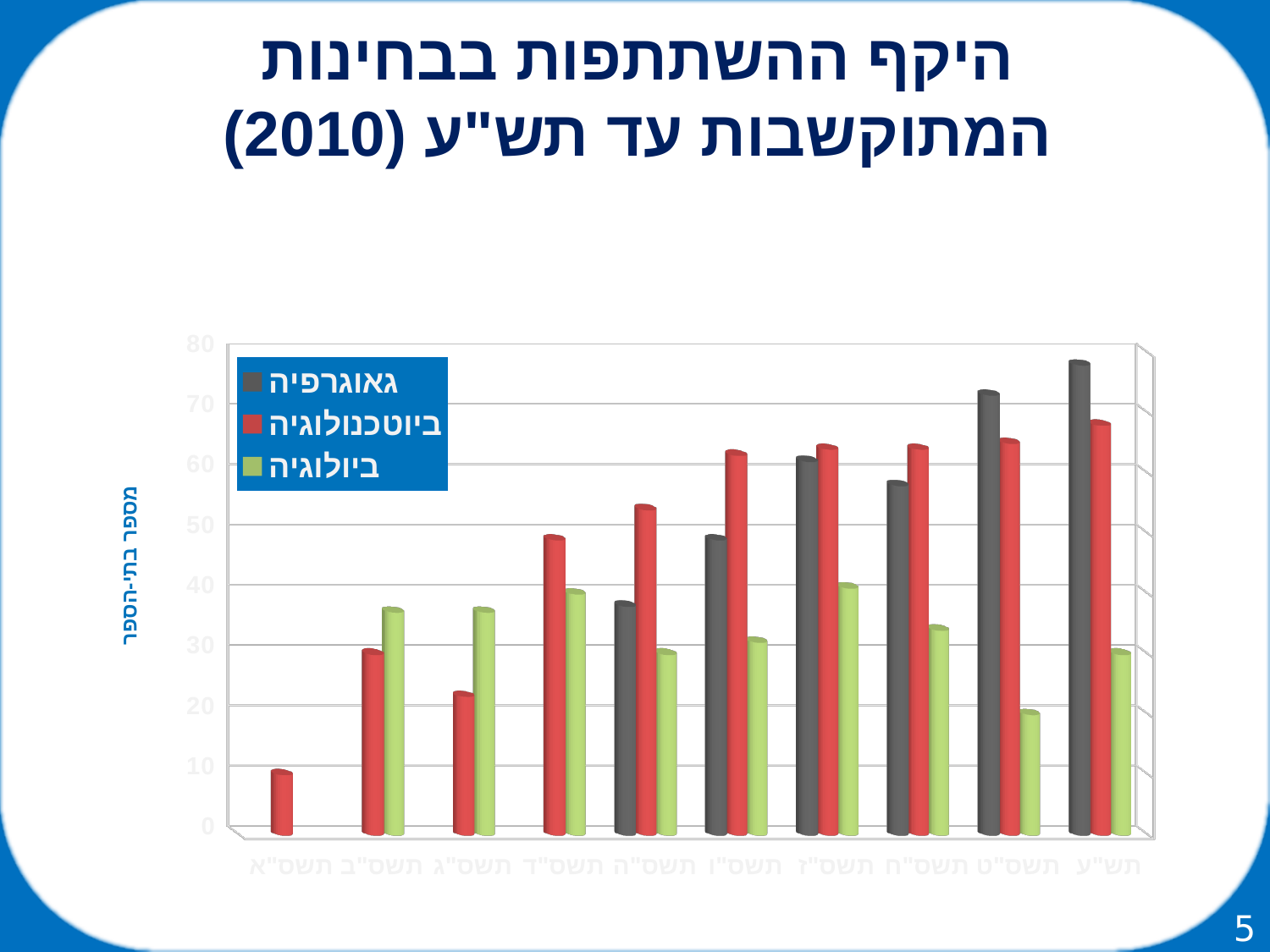
Which series has the single tallest bar in the whole chart? גאוגרפיה What is the title of the vertical axis? מספר בתי-הספר How many series does the legend list? 3 Is the value of the גאוגרפיה bar in the rightmost group greater or less than 70? greater Is the value of the ביולוגיה bar in the second group from the left greater or less than 30? greater How many category groups are plotted along the x axis? 10 How many series have a bar in the leftmost group? 1 Do the ביוטכנולוגיה values generally rise or fall from left to right across the chart? rise In the rightmost group, which series has the tallest bar? גאוגרפיה What kind of chart is shown on the slide? bar chart What are the three series named in the legend? גאוגרפיה, ביוטכנולוגיה, ביולוגיה